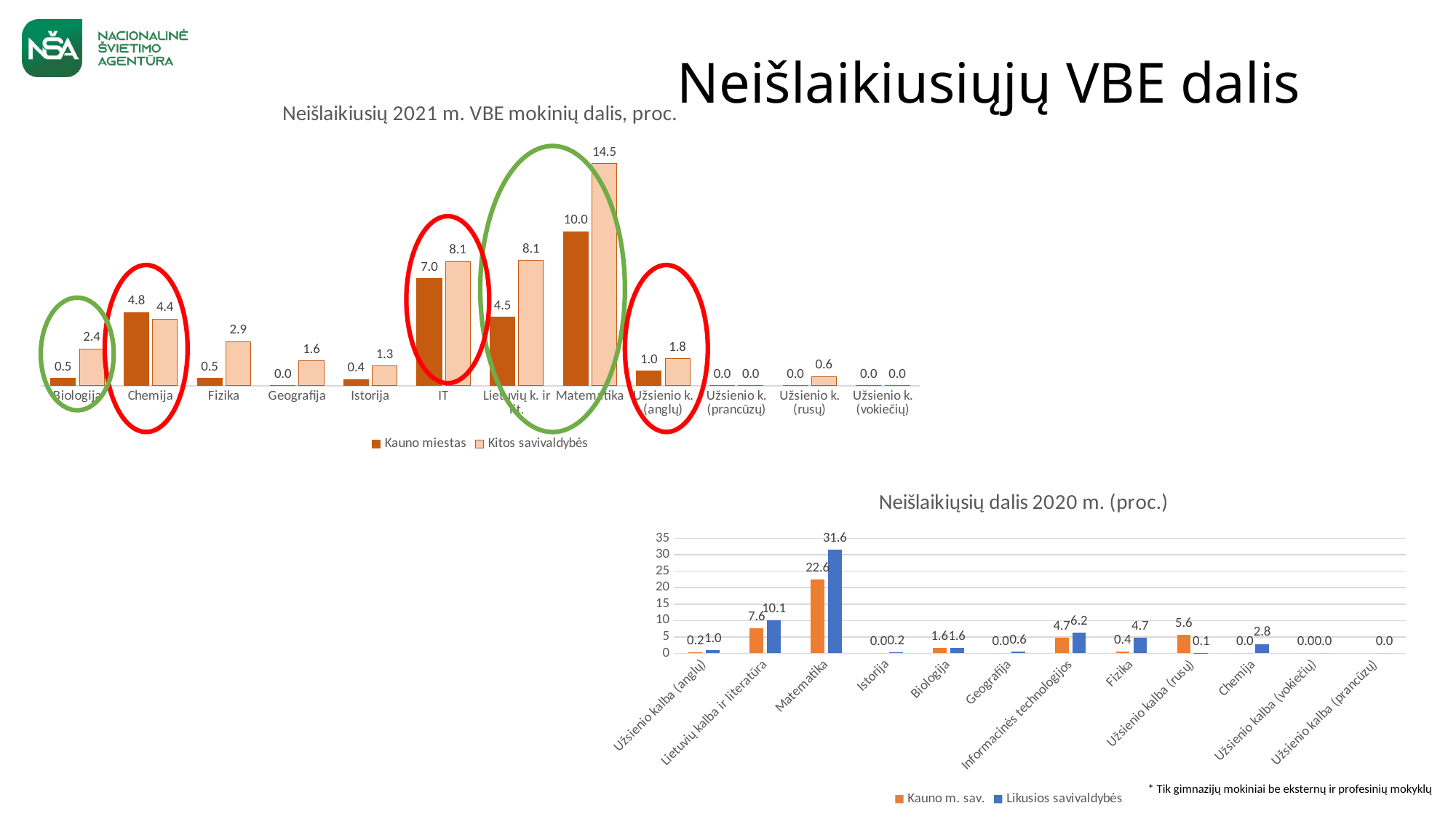
In the top chart (Neišlaikiusių 2021 m. VBE mokinių dalis, proc.), what is the difference between Kitos savivaldybės and Kauno miestas in Matematika? 4.5 In the bottom chart (Neišlaikiusių dalis 2020 m. (proc.)), what is the value for Kauno m. sav. in Užsienio kalba (rusų)? 5.6 In the bottom chart (Neišlaikiusių dalis 2020 m. (proc.)), what is the difference between Likusios savivaldybės and Kauno m. sav. in Matematika? 9.0 What kind of chart is the bottom chart (Neišlaikiusių dalis 2020 m. (proc.))? Bar chart In the top chart (Neišlaikiusių 2021 m. VBE mokinių dalis, proc.), which category has the highest value for Kitos savivaldybės? Matematika In the bottom chart (Neišlaikiusių dalis 2020 m. (proc.)), which is larger in Fizika: Kauno m. sav. or Likusios savivaldybės? Likusios savivaldybės In the top chart (Neišlaikiusių 2021 m. VBE mokinių dalis, proc.), what is the value for Kitos savivaldybės in Chemija? 4.4 In the top chart (Neišlaikiusių 2021 m. VBE mokinių dalis, proc.), what is the value for Kauno miestas in Matematika? 10.0 In the top chart (Neišlaikiusių 2021 m. VBE mokinių dalis, proc.), how many series does the legend list? 2 In the top chart (Neišlaikiusių 2021 m. VBE mokinių dalis, proc.), how many subject categories are shown on the x axis? 12 In the top chart (Neišlaikiusių 2021 m. VBE mokinių dalis, proc.), which is larger in Chemija: Kauno miestas or Kitos savivaldybės? Kauno miestas In the bottom chart (Neišlaikiusių dalis 2020 m. (proc.)), what is the value for Likusios savivaldybės in Matematika? 31.6